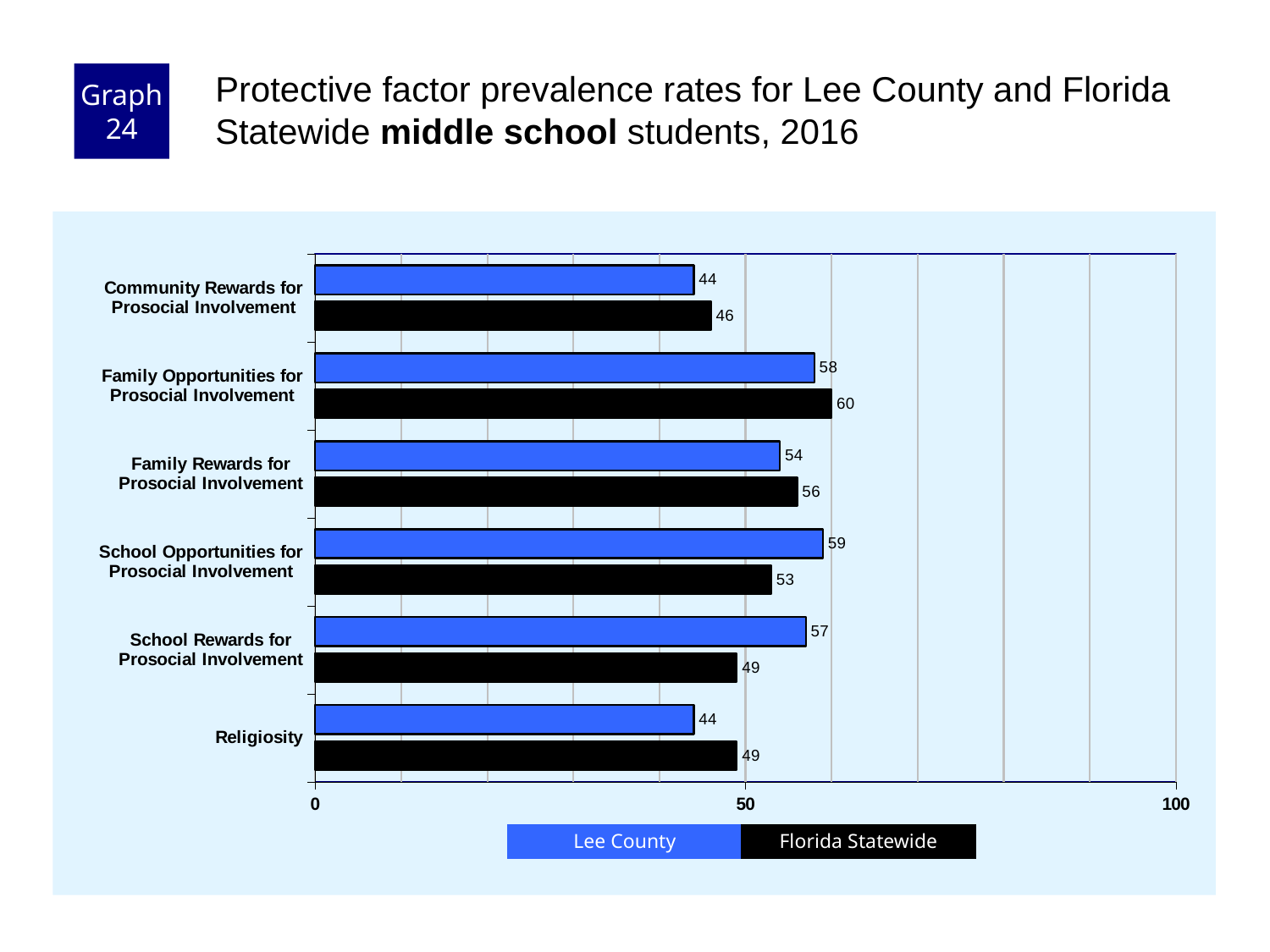
Which category has the lowest Florida Statewide value? Community Rewards for Prosocial Involvement Which category has the highest Lee County value? School Opportunities for Prosocial Involvement Is the Lee County value for Religiosity greater or less than 50? less How many series does the legend list? 2 What kind of chart is shown on the slide? bar chart What is the Lee County value for Community Rewards for Prosocial Involvement? 44 What is the difference between the Florida Statewide and Lee County values for Religiosity? 5 What is the difference between the Lee County and Florida Statewide values for School Opportunities for Prosocial Involvement? 6 What is the Florida Statewide value for Family Opportunities for Prosocial Involvement? 60 What is the Florida Statewide value for School Rewards for Prosocial Involvement? 49 How many categories are shown on the chart? 6 For Family Rewards for Prosocial Involvement, which is larger: Lee County or Florida Statewide? Florida Statewide